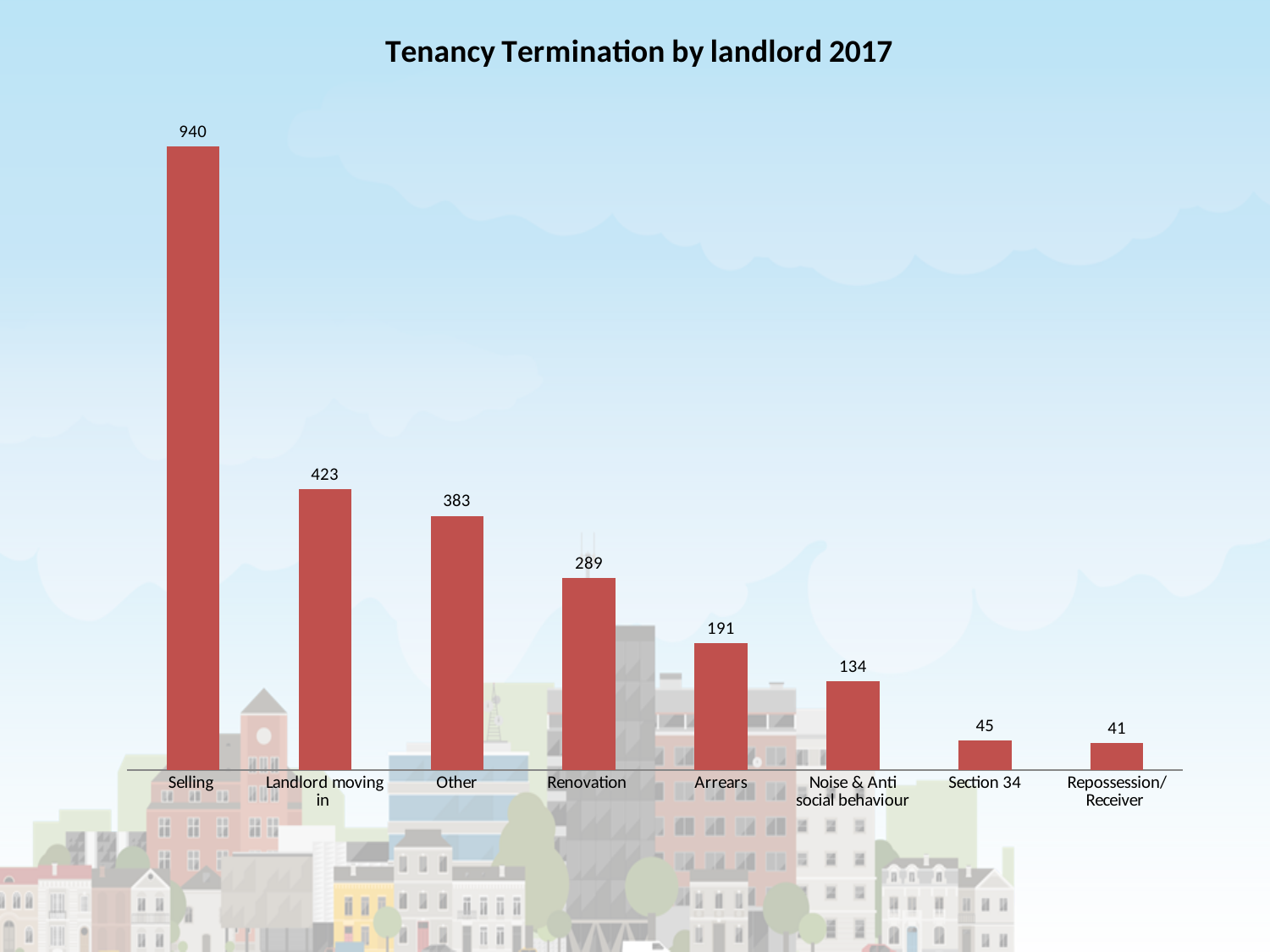
What is the difference between the values for Renovation and Arrears? 98 Which category has the lowest value? Repossession/ Receiver What kind of chart is shown on the slide? Bar chart Which is larger, the value for Other or the value for Renovation? Other What is the difference between the values for Selling and Landlord moving in? 517 How many categories are shown in the chart? 8 What is the value for Selling? 940 What is the title of the chart? Tenancy Termination by landlord 2017 Which category has the highest value? Selling What is the value for Landlord moving in? 423 What is the value for Noise & Anti social behaviour? 134 What is the value for Section 34? 45